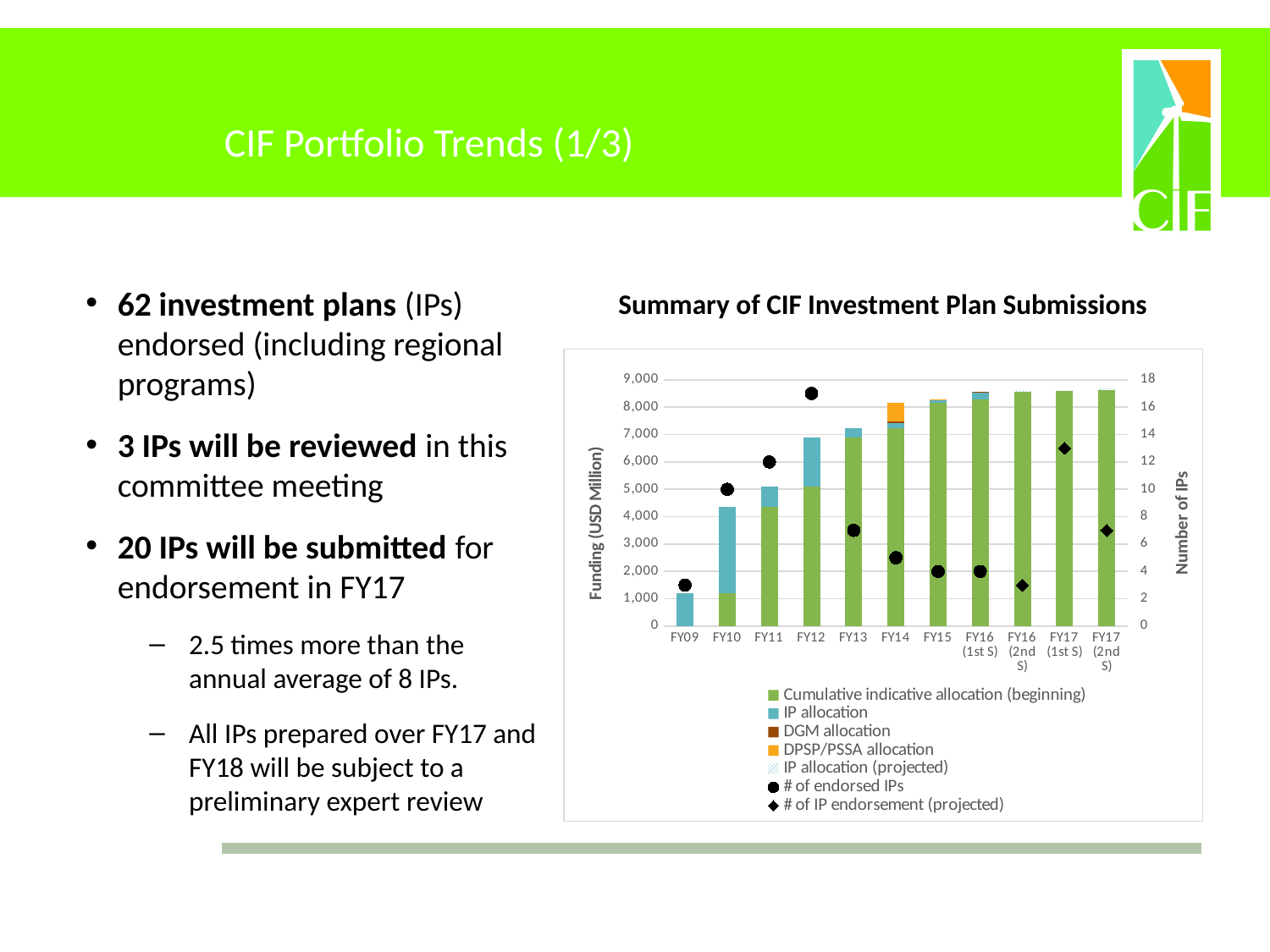
How many categories are shown along the x axis of the chart? 11 Which has more endorsed IPs, FY11 or FY13? FY11 What is the label of the left vertical axis? Funding (USD Million) Do the total funding bars generally rise or fall from FY09 to FY17 (2nd S)? rise What kind of chart is shown on the slide? combination bar and line chart Which fiscal year has the highest number of endorsed IPs? FY12 Which has a taller total funding bar, FY09 or FY10? FY10 Is the total funding bar for FY17 (2nd S) greater or less than 8,000? greater Is the total funding bar for FY09 greater or less than 2,000? less Is the number of endorsed IPs for FY12 greater or less than 14? greater How many series does the chart's legend list? 7 What is the title of the chart? Summary of CIF Investment Plan Submissions